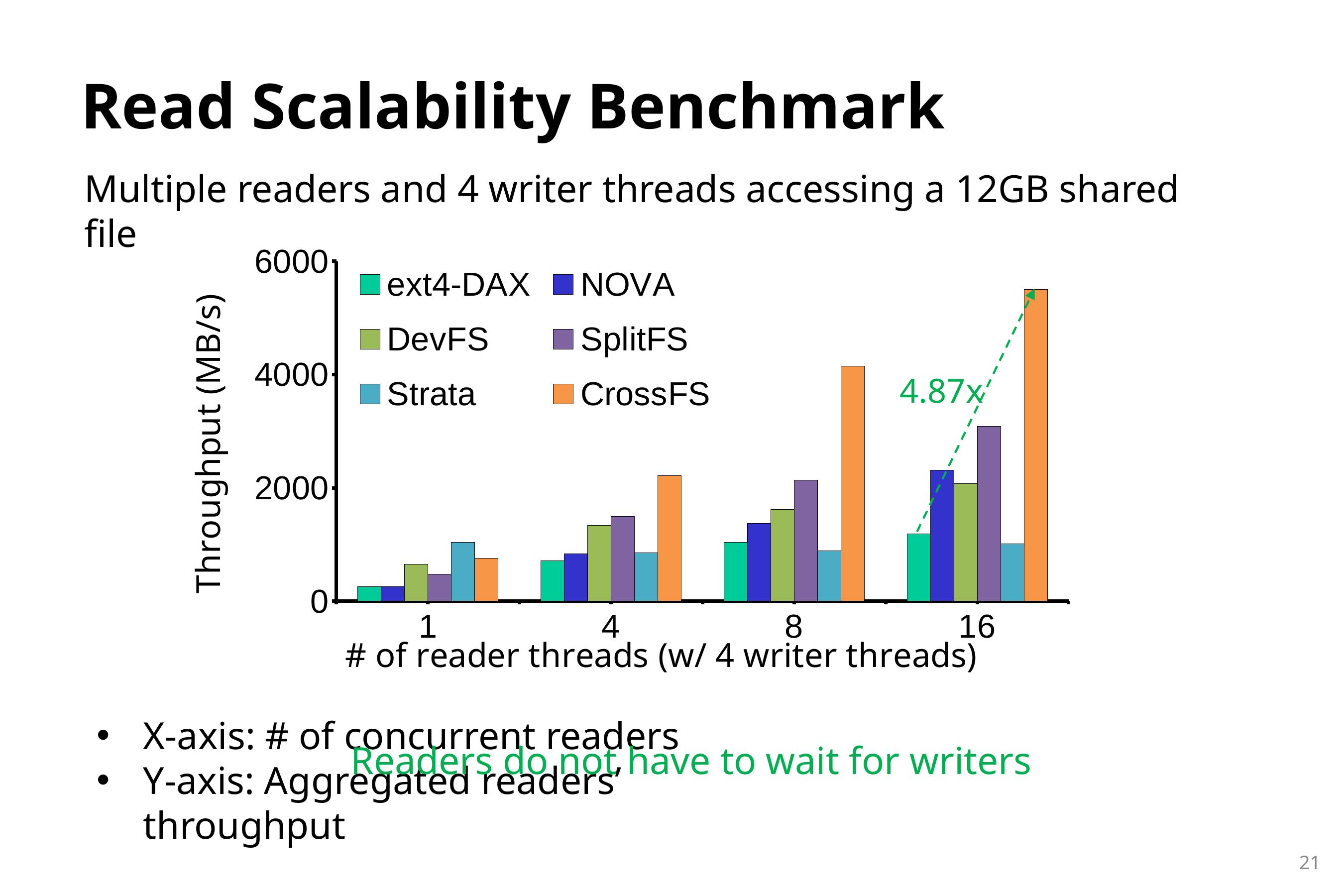
How many reader-thread counts are shown on the x axis? 4 At 16 reader threads, which has higher throughput, CrossFS or SplitFS? CrossFS How many series does the legend list? 6 Which file system has the highest throughput at 8 reader threads? CrossFS Is the throughput of Strata at 1 reader thread greater or less than 2000? less Is the throughput of SplitFS at 16 reader threads greater or less than 2000? greater Does the throughput of CrossFS rise or fall as the number of reader threads increases? rise What kind of chart is shown on the slide? bar chart Is the throughput of CrossFS at 16 reader threads greater or less than 4000? greater Which file system has the highest throughput at 1 reader thread? Strata What speedup factor is annotated on the chart at 16 reader threads? 4.87x Which file system has the highest throughput at 16 reader threads? CrossFS